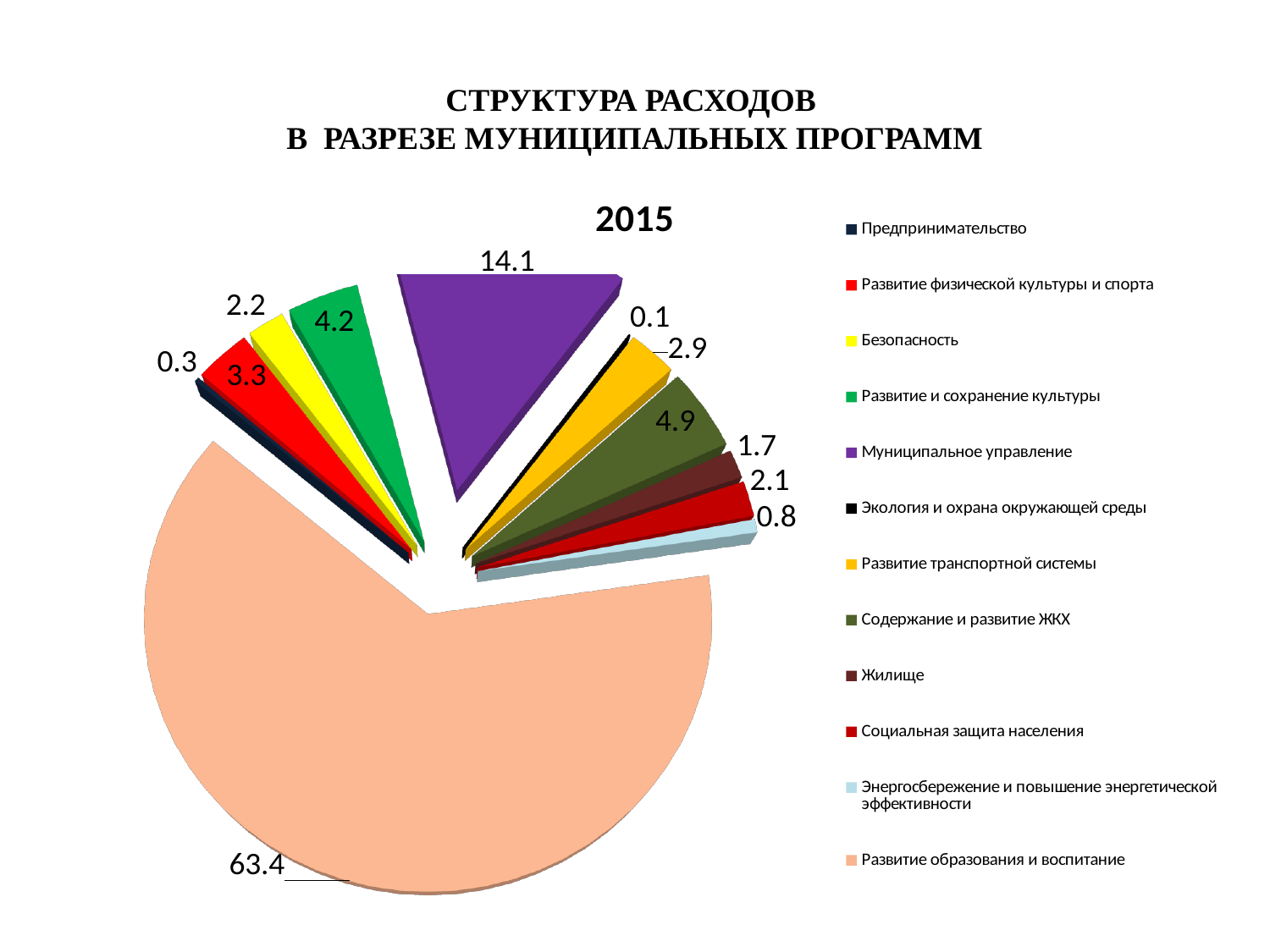
What is the value shown for Содержание и развитие ЖКХ? 4.9 What year is shown as the chart title? 2015 What is the value shown for Развитие физической культуры и спорта? 3.3 Which is larger, the value for Развитие и сохранение культуры or the value for Безопасность? Развитие и сохранение культуры What is the value shown for Муниципальное управление? 14.1 How many entries does the legend list? 12 What is the value shown for Развитие образования и воспитание? 63.4 What is the difference between the values for Муниципальное управление and Содержание и развитие ЖКХ? 9.2 How many categories does the pie chart show? 12 What kind of chart is shown on the slide? Pie chart Which category has the largest slice of the pie? Развитие образования и воспитание Which category has the smallest slice of the pie? Экология и охрана окружающей среды